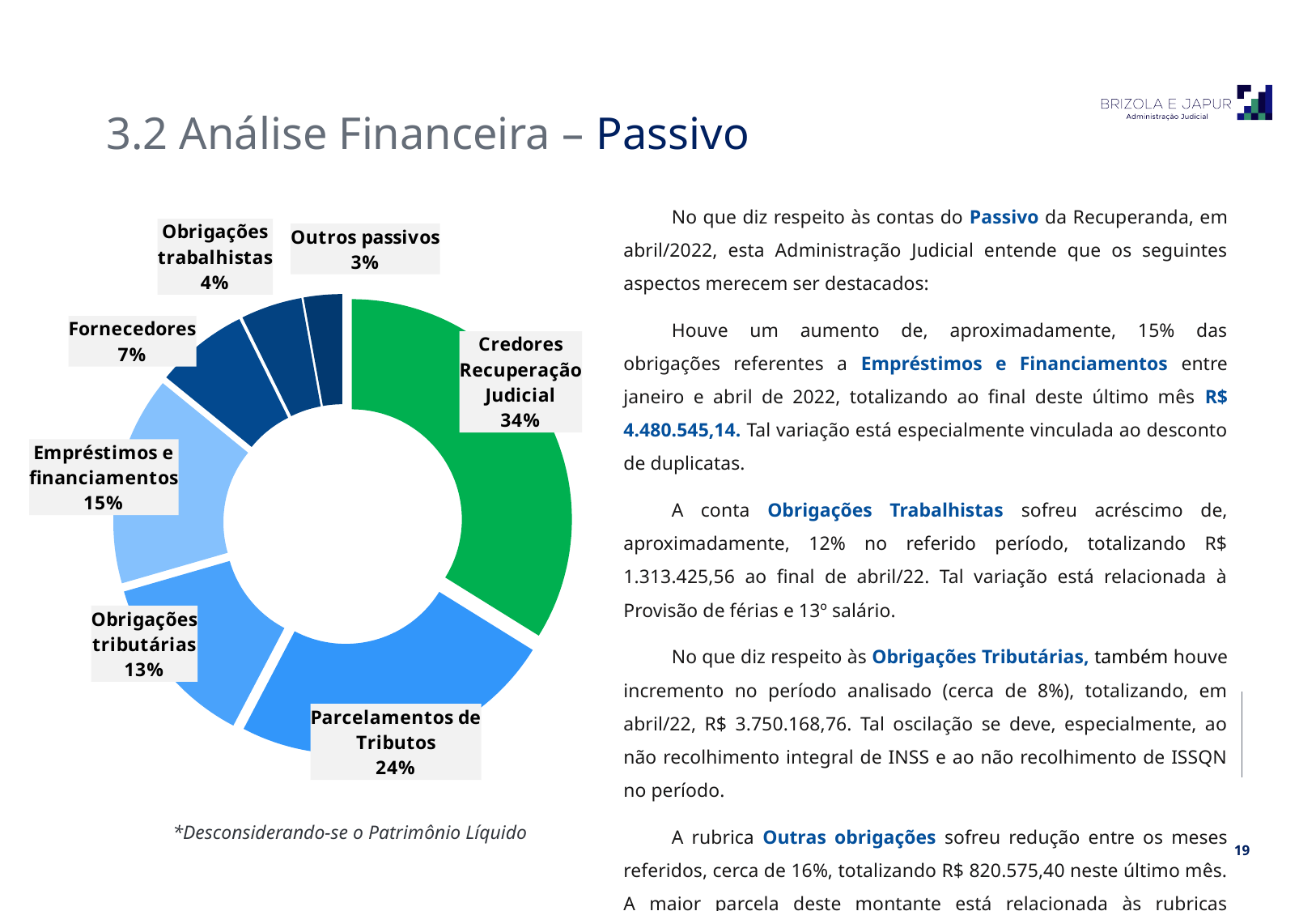
What percentage is shown for Empréstimos e financiamentos? 15% What note appears below the chart? *Desconsiderando-se o Patrimônio Líquido What share of the passivo does Credores Recuperação Judicial represent? 34% How many categories are shown in the chart? 7 Which category has the smallest share of the chart? Outros passivos Which is larger, Empréstimos e financiamentos or Obrigações tributárias? Empréstimos e financiamentos Which category has the largest share of the chart? Credores Recuperação Judicial What is the difference in percentage points between Parcelamentos de Tributos and Obrigações tributárias? 11 percentage points What percentage is shown for Parcelamentos de Tributos? 24% What percentage is shown for Fornecedores? 7% What kind of chart is shown on the slide? Pie chart (donut) What is the combined share of Obrigações trabalhistas and Outros passivos? 7%